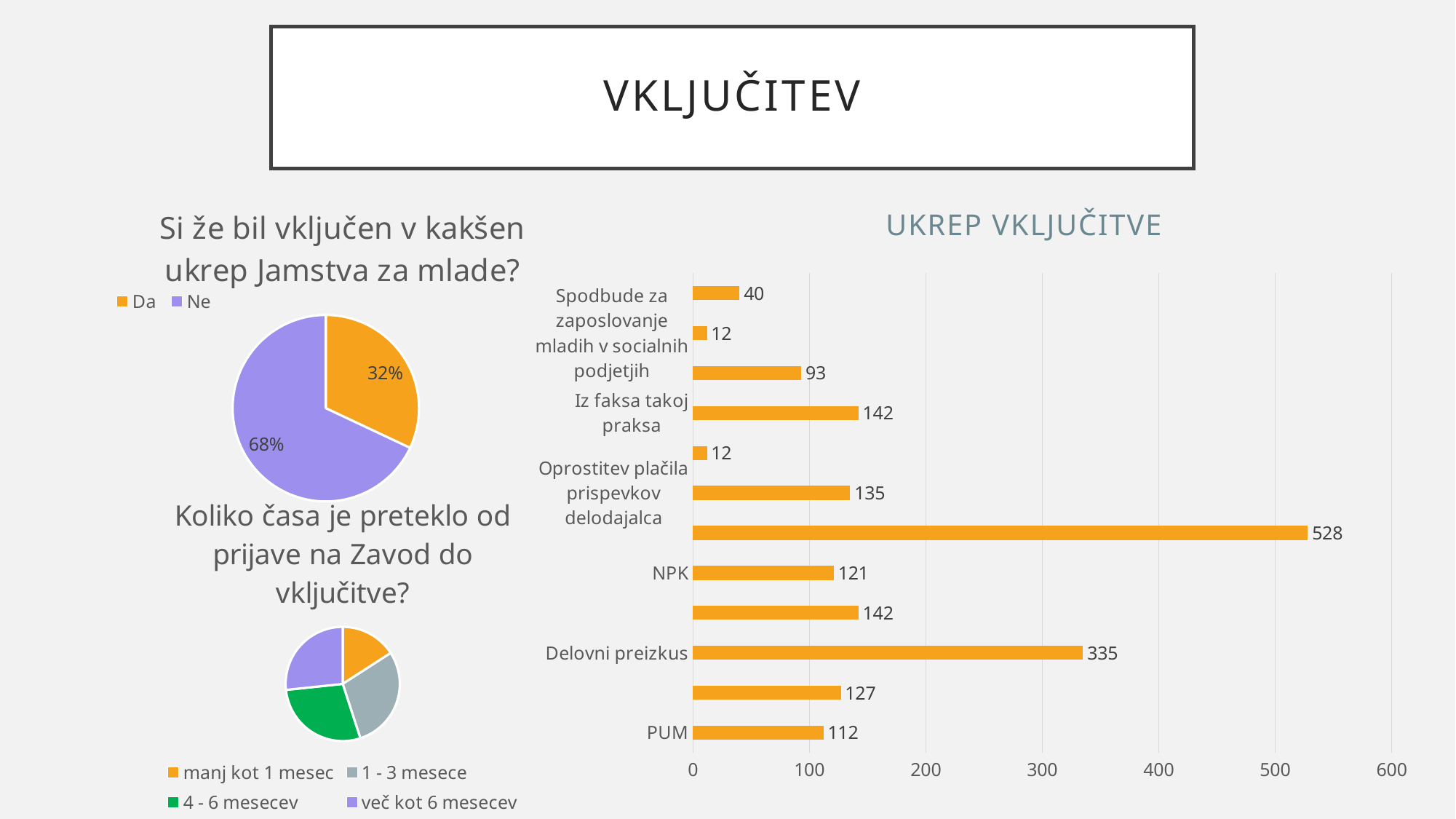
In the chart 'UKREP VKLJUČITVE', what is the value for NPK? 121 In the chart 'UKREP VKLJUČITVE', what is the highest value shown on any bar? 528 In the pie chart 'Si že bil vključen v kakšen ukrep Jamstva za mlade?', what share of respondents answered 'Da'? 32% What kind of chart is 'UKREP VKLJUČITVE'? Bar chart In the pie chart 'Koliko časa je preteklo od prijave na Zavod do vključitve?', which category has the smallest slice? manj kot 1 mesec In the chart 'UKREP VKLJUČITVE', how many bars are plotted? 12 In the pie chart 'Si že bil vključen v kakšen ukrep Jamstva za mlade?', which answer has the larger share, 'Da' or 'Ne'? Ne How many categories does the legend of the pie chart 'Koliko časa je preteklo od prijave na Zavod do vključitve?' list? 4 In the pie chart 'Si že bil vključen v kakšen ukrep Jamstva za mlade?', by how many percentage points does 'Ne' exceed 'Da'? 36 percentage points In the chart 'UKREP VKLJUČITVE', what is the value for Delovni preizkus? 335 In the pie chart 'Si že bil vključen v kakšen ukrep Jamstva za mlade?', what share of respondents answered 'Ne'? 68% In the chart 'UKREP VKLJUČITVE', what is the value for PUM? 112